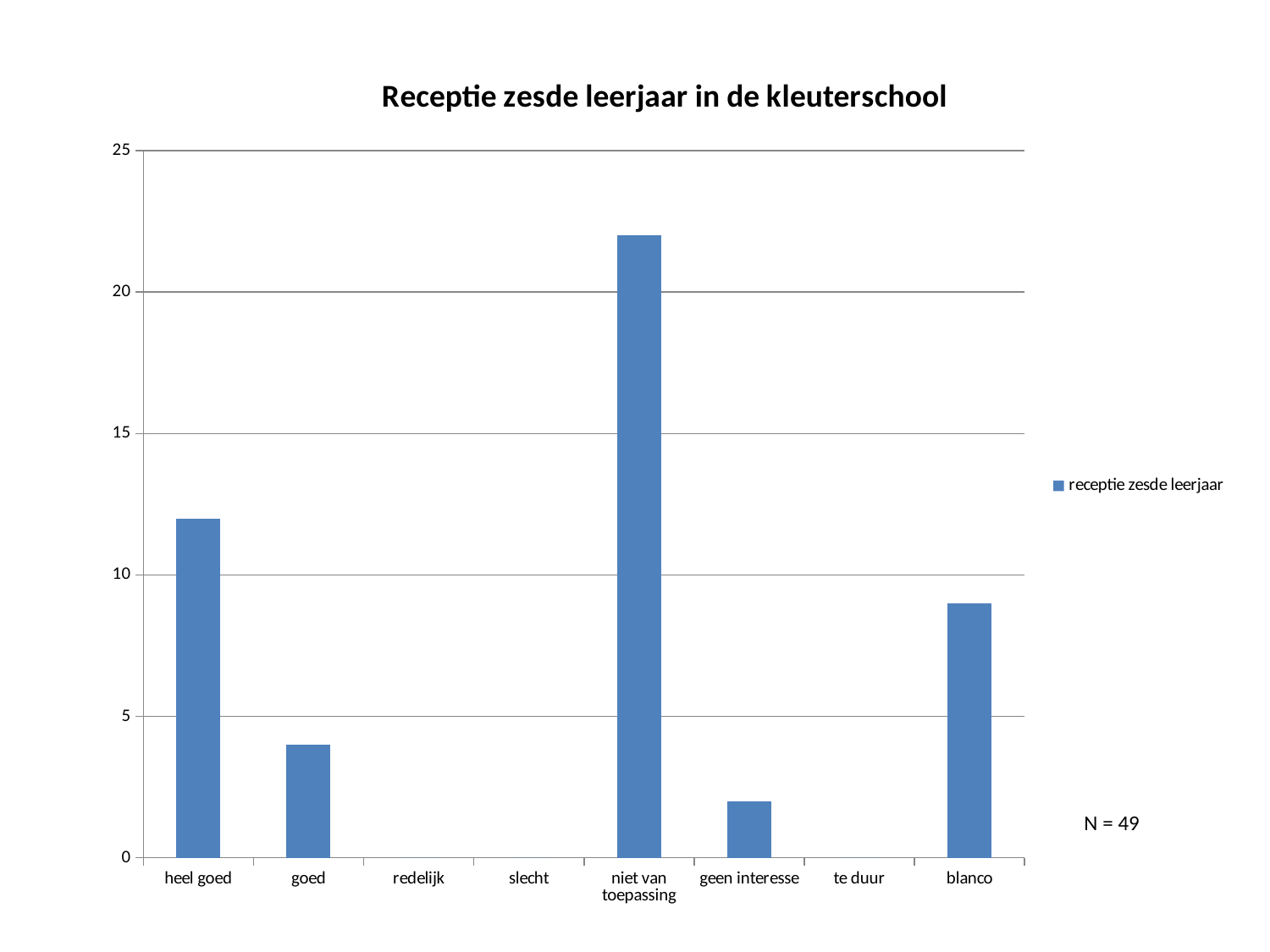
Which is larger, the value for heel goed or the value for blanco? heel goed What kind of chart is shown on the slide? bar chart How many series does the legend list? 1 Which category has the highest bar? niet van toepassing What is the name of the series in the legend? receptie zesde leerjaar How many categories are shown on the x axis of the chart? 8 Is the value for blanco greater or less than 10? less What is the title of the chart? Receptie zesde leerjaar in de kleuterschool Is the value for goed greater or less than 5? less Is the value for heel goed greater or less than 10? greater How many categories have a value of 0 (no visible bar)? 3